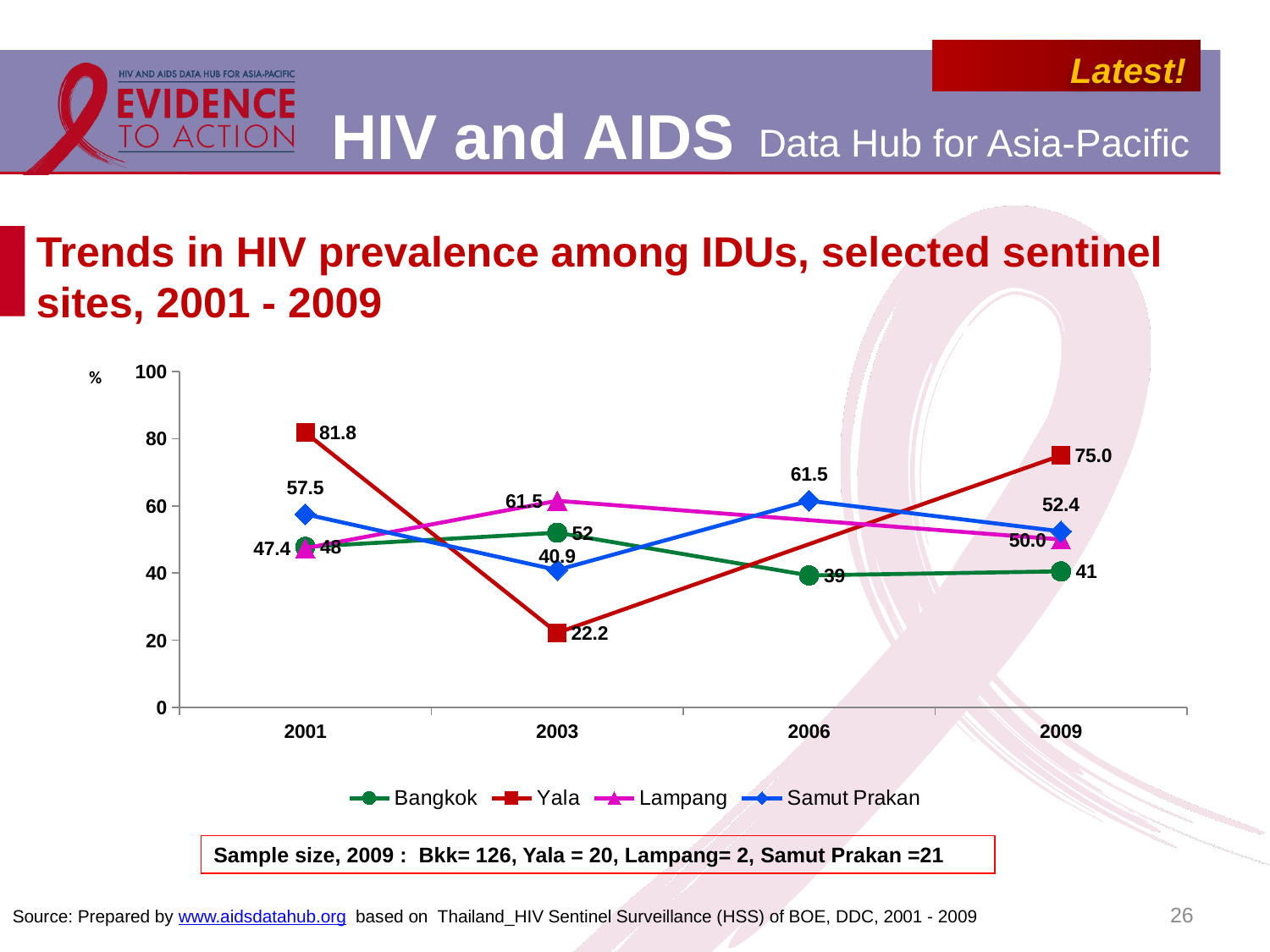
In 2009, which is larger: the value for Bangkok or the value for Samut Prakan? Samut Prakan What kind of chart is shown on the slide? Line chart How many series does the legend list? 4 Which sentinel site has the highest value in 2001? Yala What is the value for Yala in 2003? 22.2 What is the difference between Yala's value in 2001 and its value in 2003? 59.6 What is the value for Bangkok in 2006? 39 What is the value for Lampang in 2009? 50.0 Does the value for Yala rise or fall from 2003 to 2009? Rise What is the value for Samut Prakan in 2006? 61.5 Which sentinel site has the lowest value in 2003? Yala What is the HIV prevalence value for Yala in 2001? 81.8